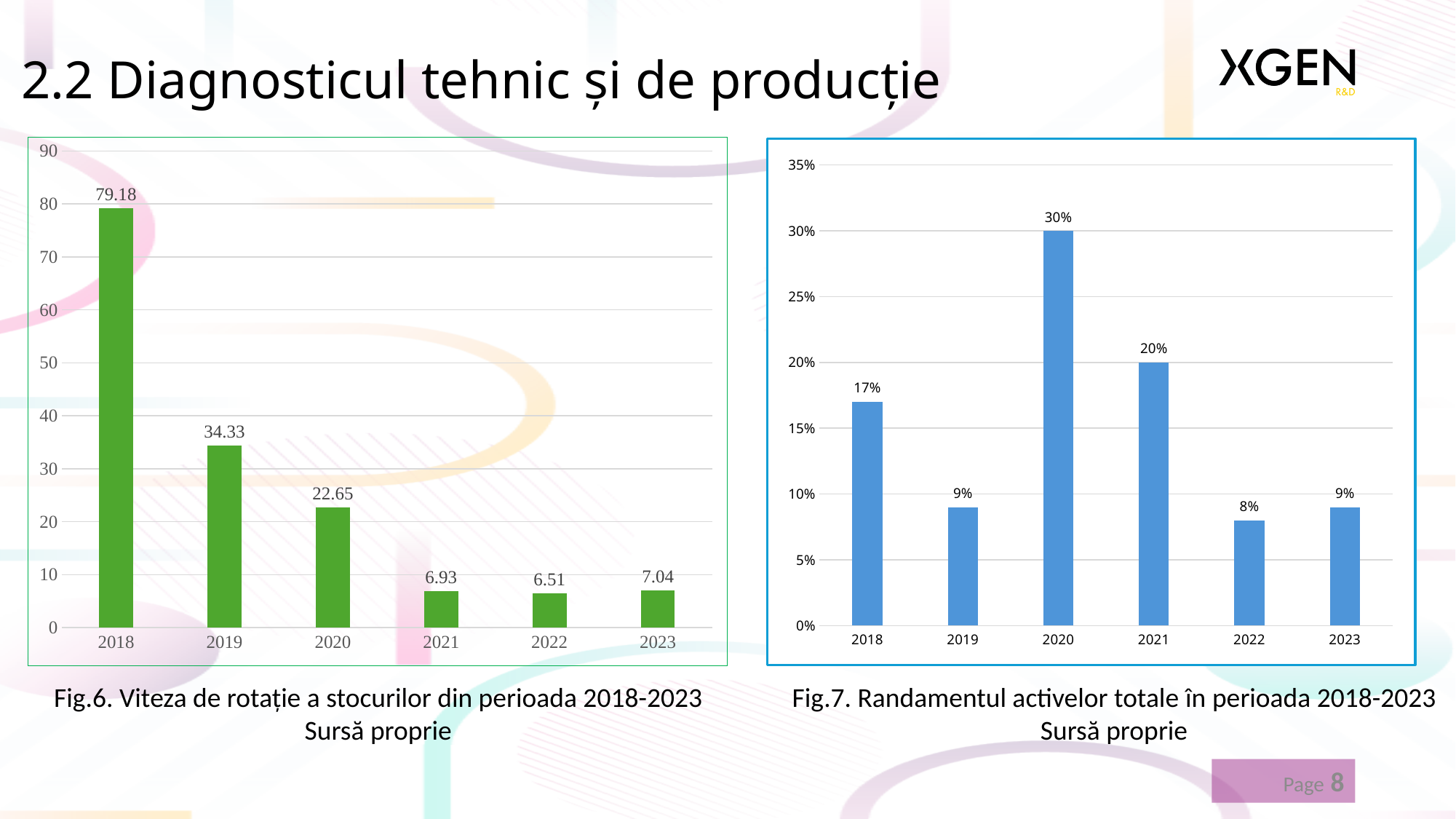
In the right chart (Fig.7), which is larger, the value for 2018 or the value for 2021? 2021 In the left chart (Fig.6), how many years are shown on the x axis? 6 In the left chart (Fig.6), what is the value for 2018? 79.18 In the right chart (Fig.7), what is the value for 2021? 20% In the left chart (Fig.6), what is the value for 2022? 6.51 In the left chart (Fig.6), what is the difference between the values for 2019 and 2020? 11.68 In the right chart (Fig.7), what is the difference between the values for 2020 and 2018? 13% In the right chart (Fig.7), which year has the lowest value? 2022 What kind of chart is the right chart (Fig.7)? Bar chart In the left chart (Fig.6), which year has the highest value? 2018 In the right chart (Fig.7), what is the value for 2020? 30% In the left chart (Fig.6), which year has the lowest value? 2022